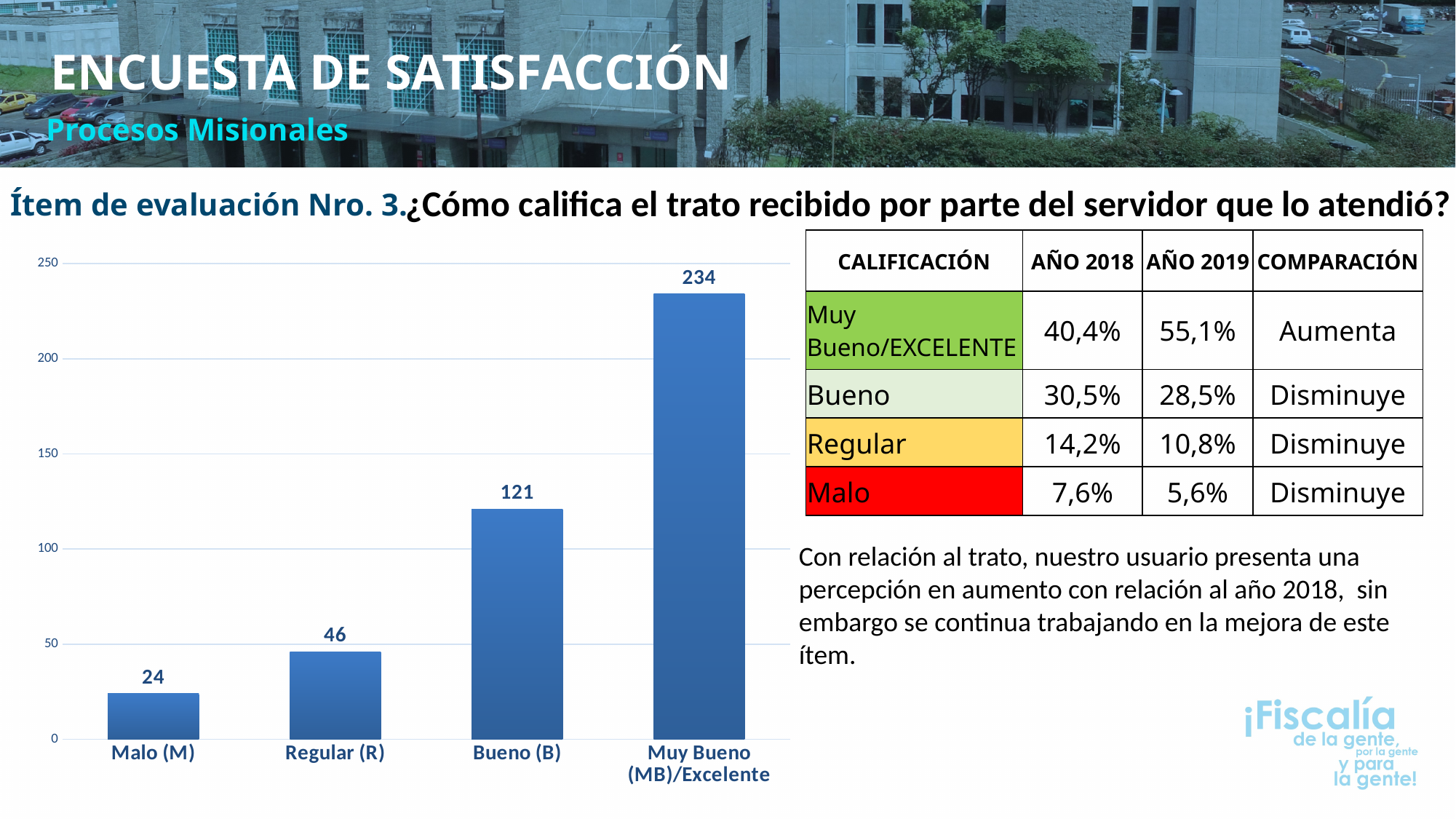
What is the value for Malo (M) in the bar chart? 24 What is the difference between the values for Regular (R) and Malo (M)? 22 Which is larger, the value for Bueno (B) or the value for Regular (R)? Bueno (B) What is the value for Regular (R) in the bar chart? 46 What kind of chart is shown on the slide? Bar chart What is the value for Bueno (B) in the bar chart? 121 Do the values rise or fall from left to right along the x axis of the bar chart? Rise Which category has the lowest value in the bar chart? Malo (M) What is the difference between the values for Muy Bueno (MB)/Excelente and Bueno (B)? 113 How many categories are shown in the bar chart? 4 What is the value for Muy Bueno (MB)/Excelente in the bar chart? 234 Which category has the highest value in the bar chart? Muy Bueno (MB)/Excelente